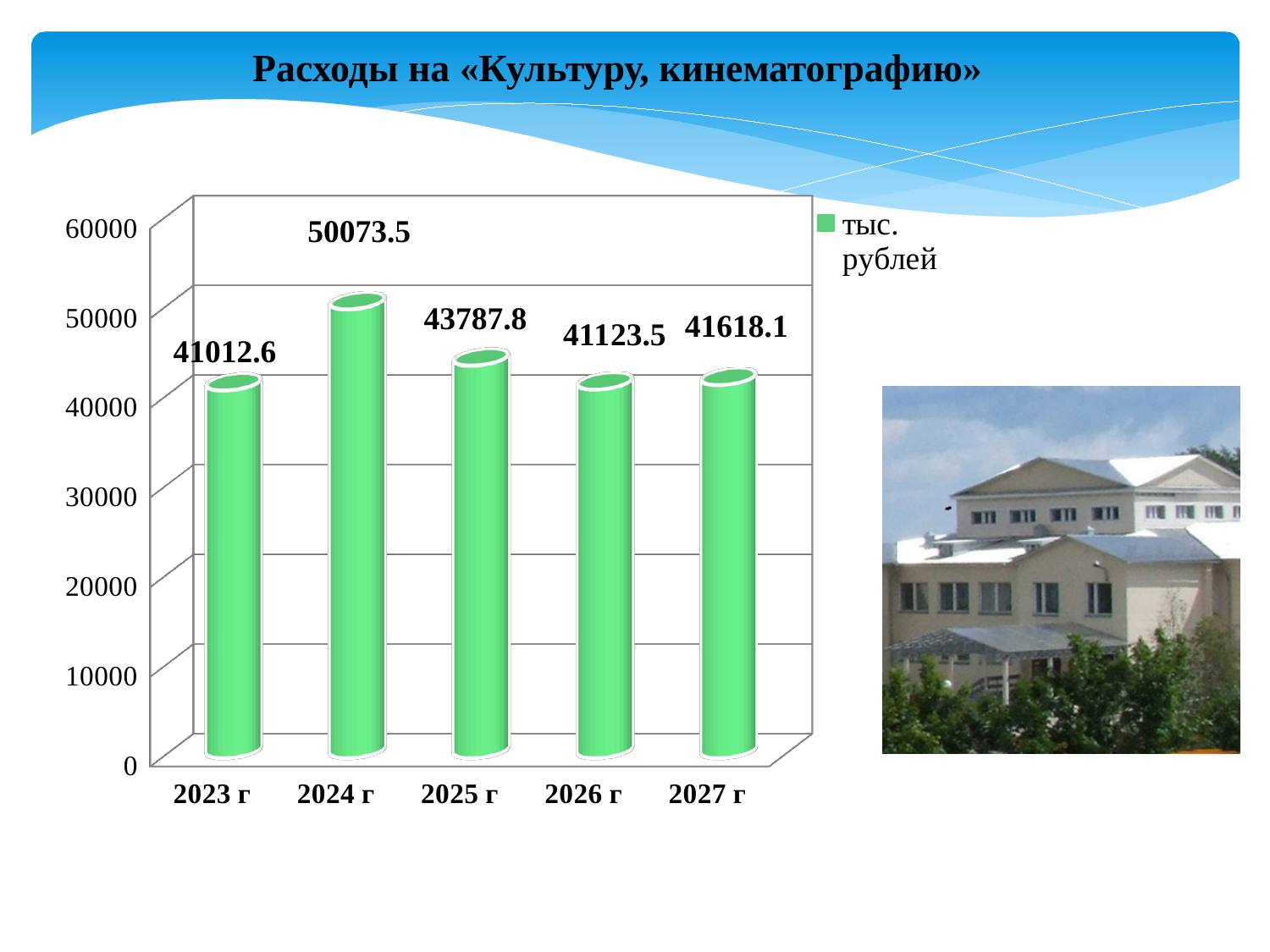
What is the value for 2027 г? 41618.1 What kind of chart is shown on the slide? bar chart Which is larger, the value for 2025 г or the value for 2027 г? 2025 г Which year has the highest value? 2024 г What is the legend entry of the chart? тыс. рублей What is the difference between the values for 2024 г and 2023 г? 9060.9 Which year has the lowest value? 2023 г How many years are shown on the x axis? 5 Is the value for 2024 г greater or less than 50000? greater What is the value for 2024 г? 50073.5 What is the value for 2023 г? 41012.6 What is the difference between the values for 2025 г and 2026 г? 2664.3